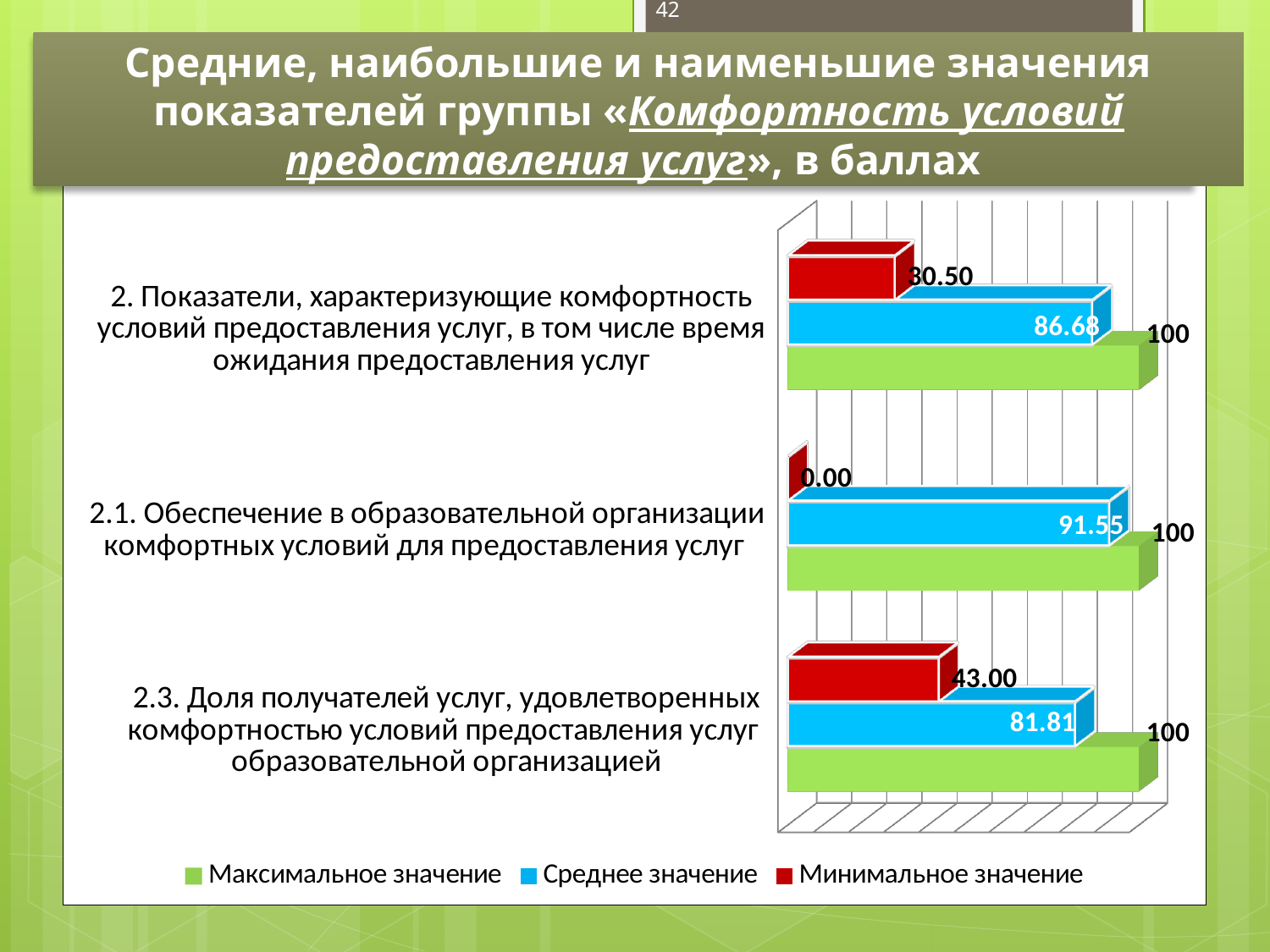
Which indicator has the lowest Минимальное значение? 2.1. Обеспечение в образовательной организации комфортных условий для предоставления услуг What is the Среднее значение for indicator 2.1 (Обеспечение в образовательной организации комфортных условий для предоставления услуг)? 91.55 Which is larger: the Минимальное значение for indicator 2 or for indicator 2.3? Indicator 2.3 (43.00) What kind of chart is shown on the slide? Bar chart Which indicator has the highest Среднее значение? 2.1. Обеспечение в образовательной организации комфортных условий для предоставления услуг What is the Максимальное значение for indicator 2.3? 100 What is the Минимальное значение for indicator 2.3 (Доля получателей услуг, удовлетворенных комфортностью условий предоставления услуг образовательной организацией)? 43.00 How many indicators (categories) are shown in the chart? 3 How many series does the legend list? 3 What is the difference between the Среднее значение for indicator 2.1 and for indicator 2.3? 9.74 What is the Минимальное значение for indicator 2 (Показатели, характеризующие комфортность условий предоставления услуг)? 30.50 Which colour represents Среднее значение in the chart? Blue